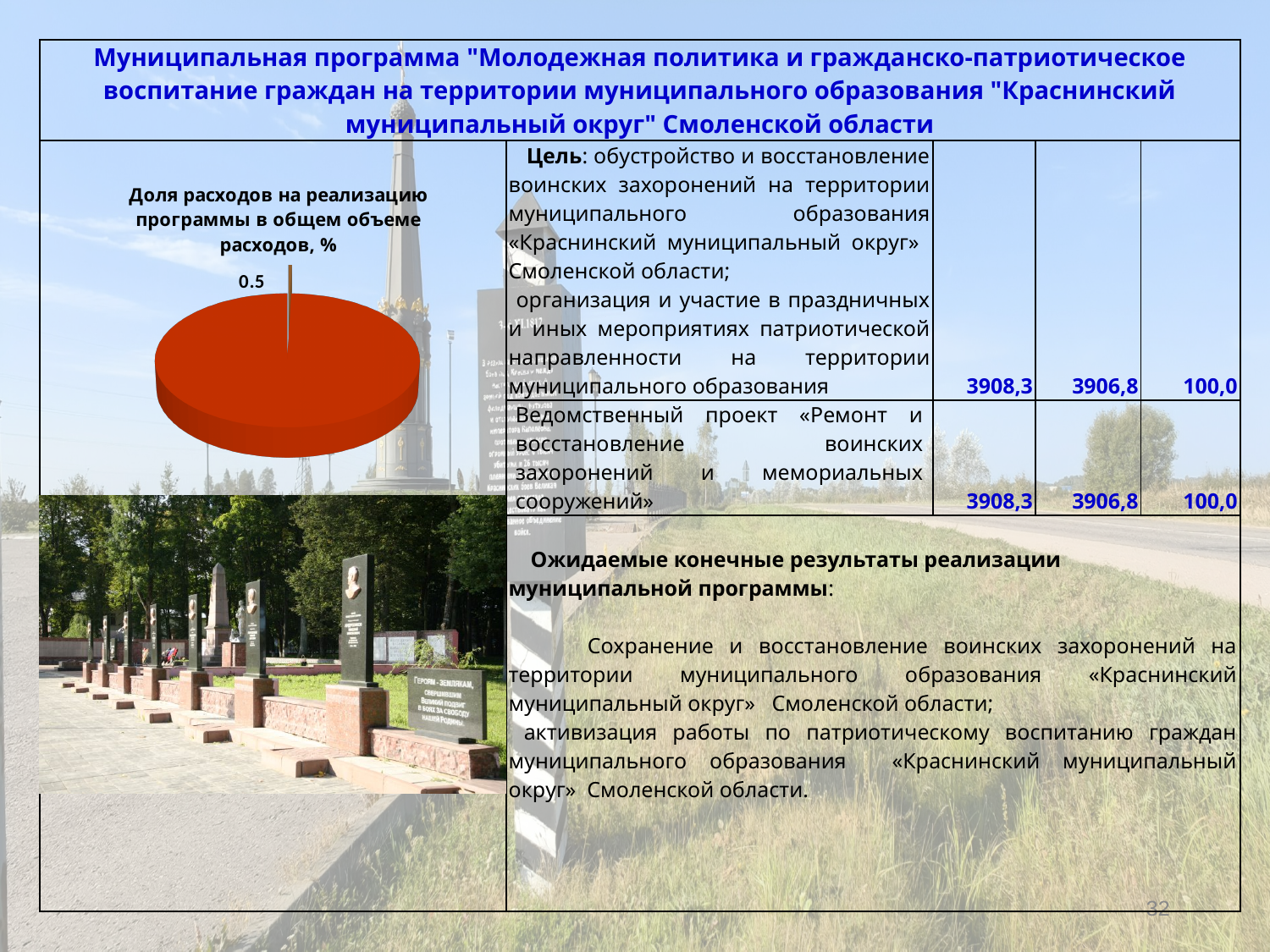
What value is printed as the data label on the pie chart? 0.5 What is the title of the pie chart? Доля расходов на реализацию программы в общем объеме расходов, % What colour is the large slice of the pie chart? red What kind of chart is shown on the slide? pie chart Does the pie chart have a legend? No